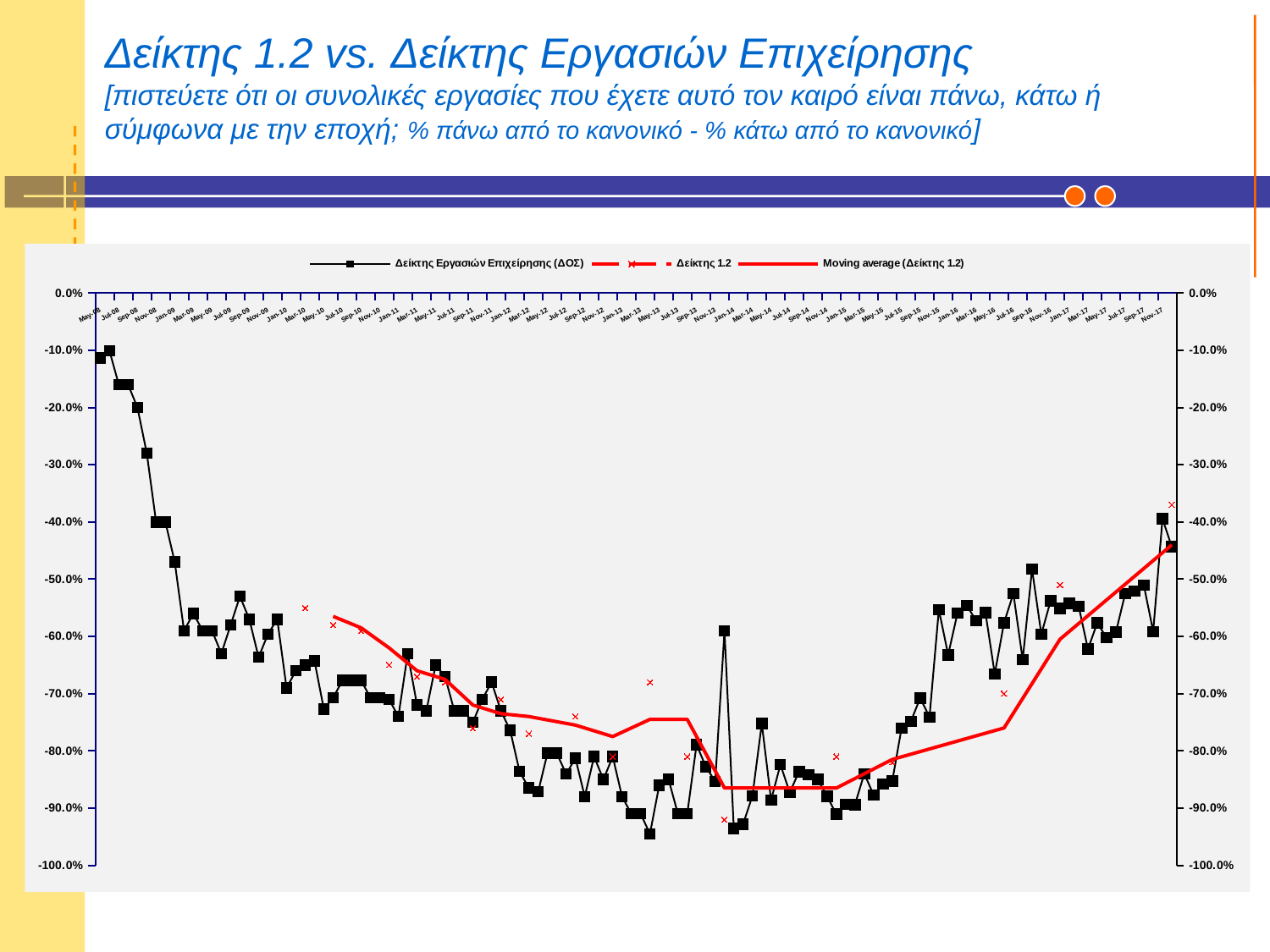
Is the value of the Δείκτης Εργασιών Επιχείρησης (ΔΟΣ) series at May-08 above or below -20.0%? above Is the value of the Δείκτης Εργασιών Επιχείρησης (ΔΟΣ) series at Nov-17 above or below -50.0%? above What is the lowest value shown on the chart's vertical axis? -100.0% Is the lowest point of the Δείκτης Εργασιών Επιχείρησης (ΔΟΣ) series above or below -90.0%? below Which is higher for the Δείκτης Εργασιών Επιχείρησης (ΔΟΣ) series: the value at May-08 or the value at Nov-17? May-08 What is the name of the third series in the chart legend? Moving average (Δείκτης 1.2) Does the Moving average (Δείκτης 1.2) series rise or fall between Jan-16 and Nov-17? rise How many series does the chart legend list? 3 Does the Δείκτης Εργασιών Επιχείρησης (ΔΟΣ) series rise or fall between May-08 and Jan-13? fall In which year does the Δείκτης Εργασιών Επιχείρησης (ΔΟΣ) series reach its lowest point? 2013 What kind of chart is shown on the slide? line chart